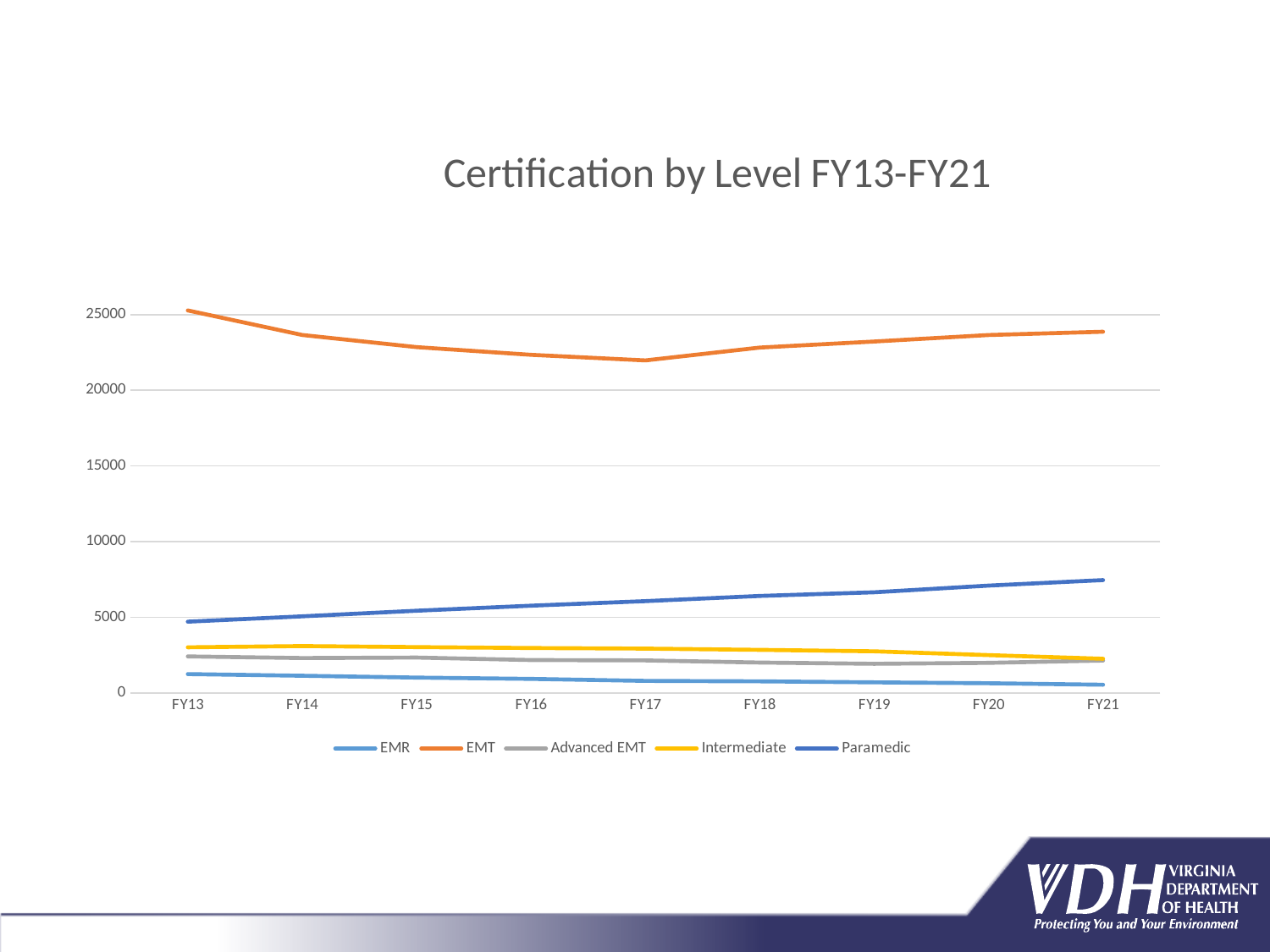
What is the title of the chart? Certification by Level FY13-FY21 Which series has the lowest values across all fiscal years? EMR Is the value for EMT in FY17 greater or less than 20000? greater Does the Paramedic line rise or fall from FY13 to FY21? rise What kind of chart is shown on the slide? line chart In FY21, which is larger, the Paramedic value or the Intermediate value? Paramedic How many fiscal years are plotted along the x axis? 9 Is the value for Paramedic in FY21 greater or less than 5000? greater Is the value for EMT in FY17 greater or less than 25000? less How many series does the legend list? 5 Which series has the highest values across all fiscal years? EMT